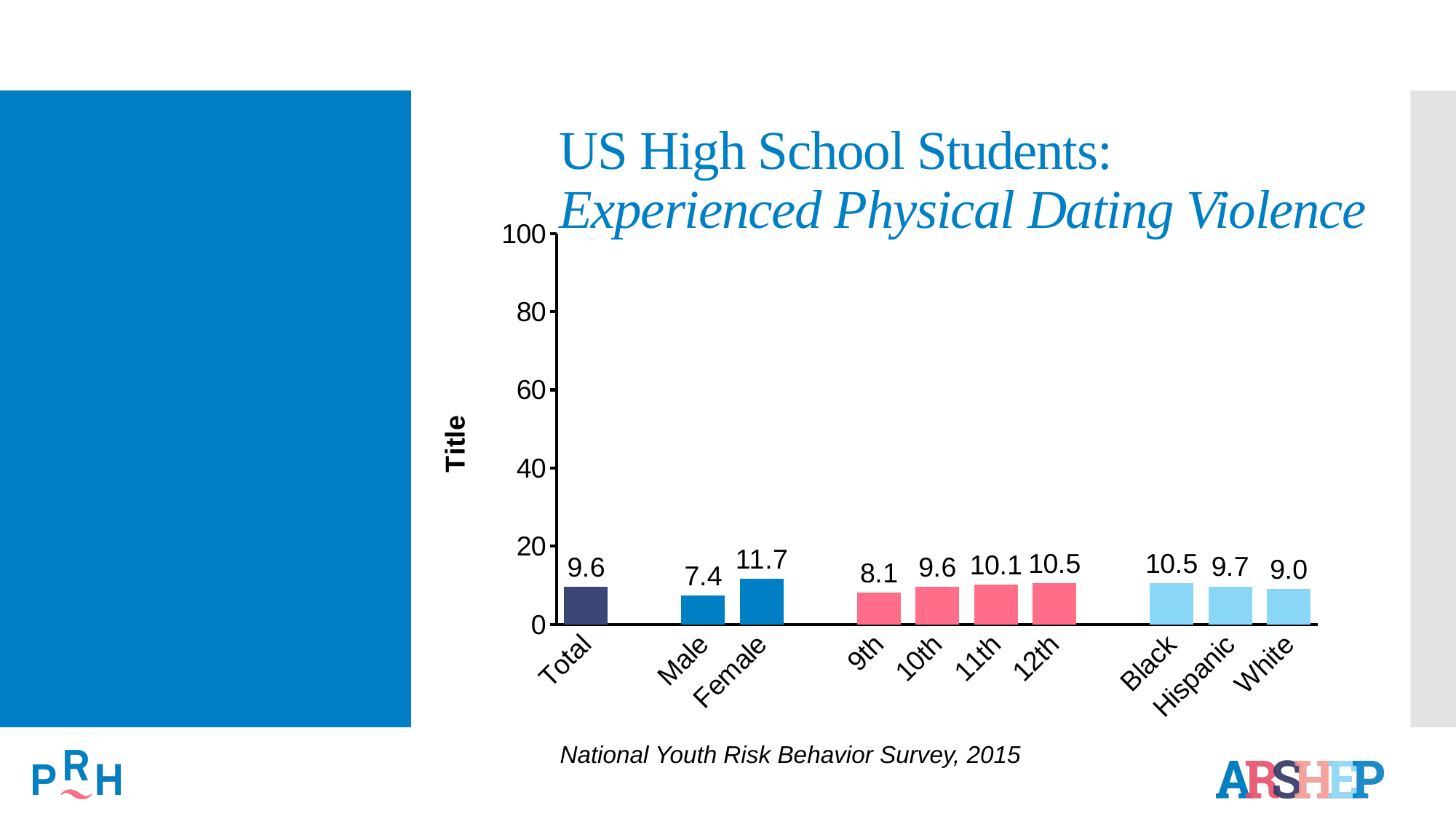
What is the value for Total? 9.6 What is the value for Female? 11.7 Do the values rise or fall from 9th grade to 12th grade? rise Is the value for 12th grade greater or less than 20? less How many bars are shown in the chart? 10 Which category has the highest value? Female What is the value for Hispanic? 9.7 Which is larger, the value for Black or the value for White? Black What is the difference between the Female and Male values? 4.3 What is the value for 9th grade? 8.1 Which category has the lowest value? Male What kind of chart is shown? bar chart